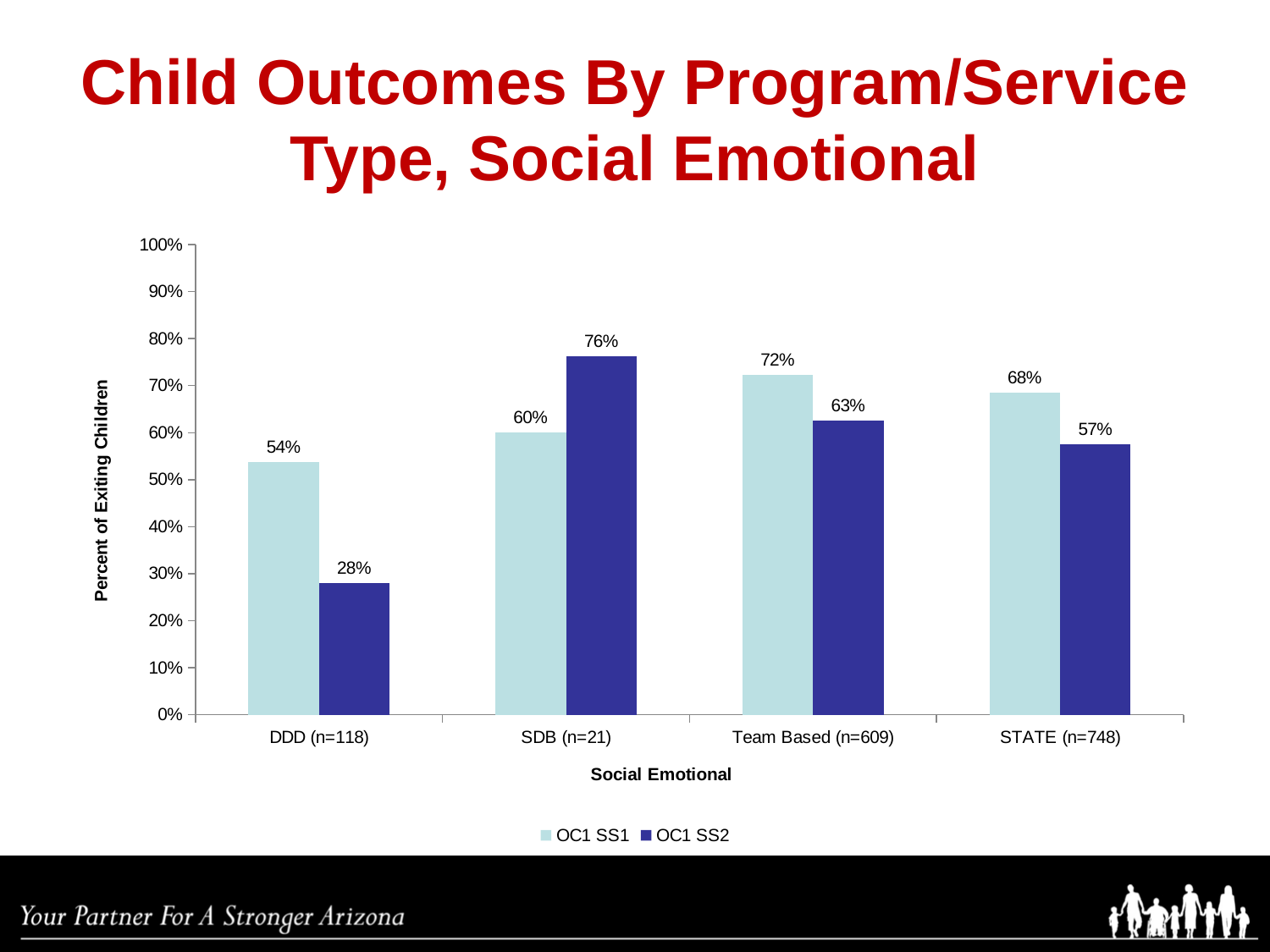
What is the OC1 SS2 value for STATE (n=748)? 57% What is the OC1 SS1 value for DDD (n=118)? 54% What kind of chart is shown on the slide? Bar chart How many categories are shown on the x axis? 4 Which is larger for SDB (n=21): the OC1 SS1 value or the OC1 SS2 value? OC1 SS2 Which category has the highest OC1 SS1 value? Team Based (n=609) Which category has the lowest OC1 SS2 value? DDD (n=118) What is the difference between the OC1 SS1 and OC1 SS2 values for DDD (n=118)? 26% What is the OC1 SS2 value for SDB (n=21)? 76% What is the label of the y axis? Percent of Exiting Children How many series does the legend list? 2 Is the OC1 SS2 value for Team Based (n=609) greater or less than 60%? greater